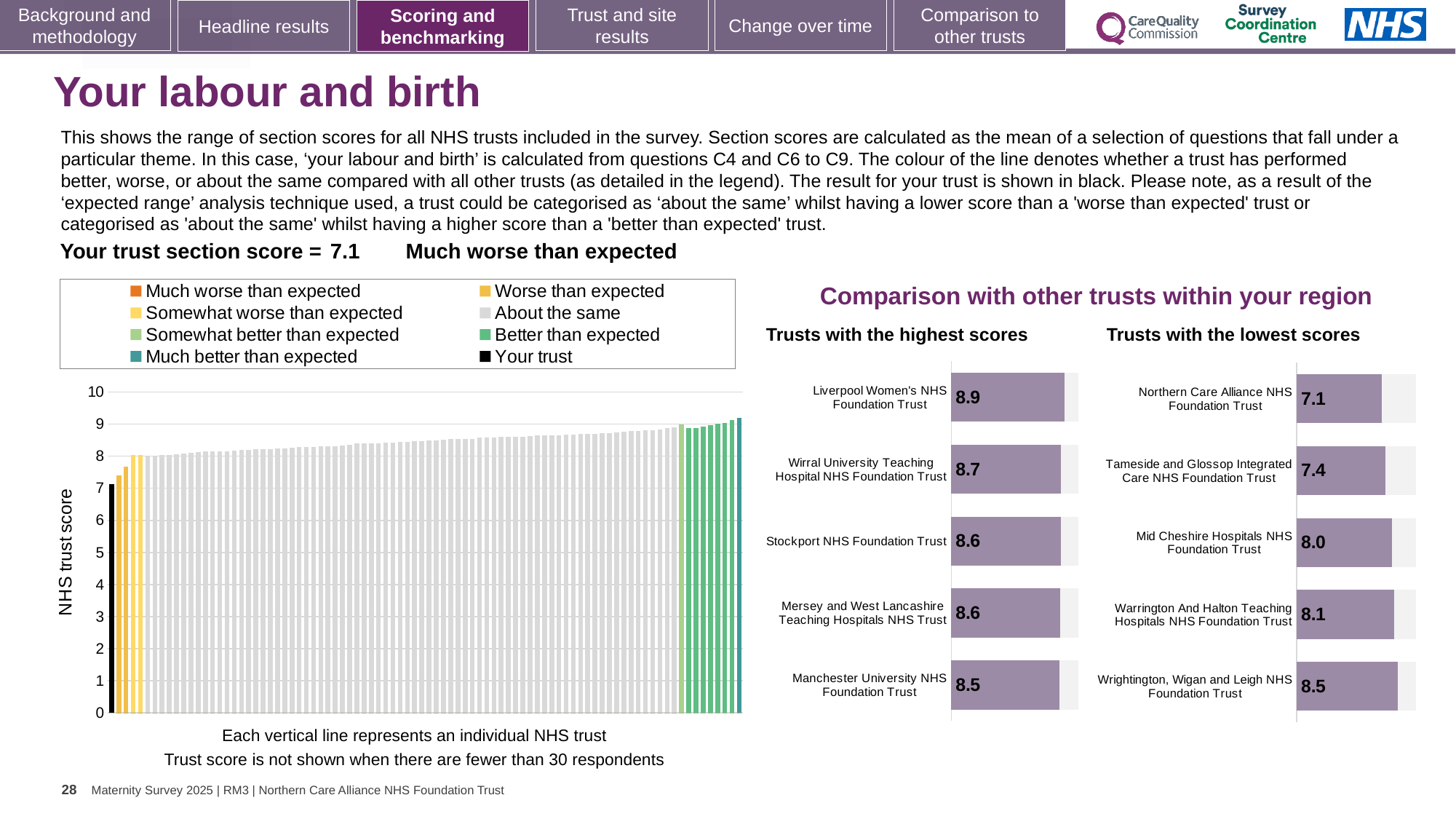
In the 'Trusts with the lowest scores' chart, how much higher is the score of Wrightington, Wigan and Leigh NHS Foundation Trust than that of Northern Care Alliance NHS Foundation Trust? 1.4 In the 'Trusts with the lowest scores' chart, which trust has the lowest score? Northern Care Alliance NHS Foundation Trust In the 'Trusts with the lowest scores' chart, what is the score for Tameside and Glossop Integrated Care NHS Foundation Trust? 7.4 In the 'Trusts with the highest scores' chart, which trust has the highest score? Liverpool Women's NHS Foundation Trust In the 'Trusts with the highest scores' chart, what is the difference between the scores of Liverpool Women's NHS Foundation Trust and Manchester University NHS Foundation Trust? 0.4 How many entries does the legend of the 'NHS trust score' chart on the left list? 8 In the 'NHS trust score' chart on the left, what is the score of the black bar representing your trust? 7.1 What kind of chart is the 'NHS trust score' chart on the left of the slide? Bar chart In the 'Trusts with the lowest scores' chart, which has the larger score: Mid Cheshire Hospitals NHS Foundation Trust or Warrington And Halton Teaching Hospitals NHS Foundation Trust? Warrington And Halton Teaching Hospitals NHS Foundation Trust How many trusts are shown in the 'Trusts with the highest scores' chart? 5 In the 'Trusts with the highest scores' chart, what is the score for Liverpool Women's NHS Foundation Trust? 8.9 In the 'NHS trust score' chart on the left, do the bar values rise or fall from left to right? Rise